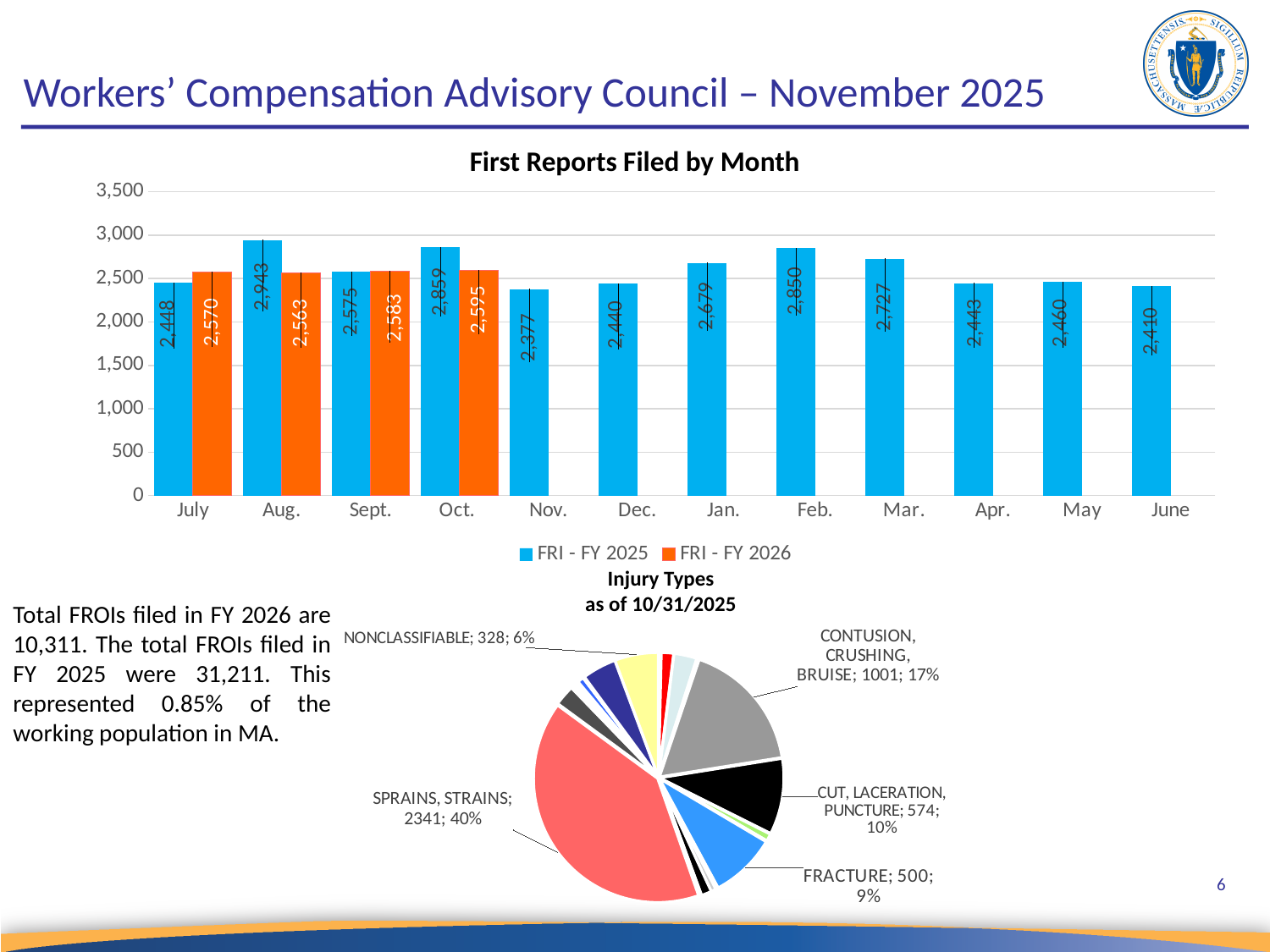
In the 'First Reports Filed by Month' chart, is the FRI - FY 2025 value for Feb. greater or less than 2,500? greater In the 'First Reports Filed by Month' chart, what is the FRI - FY 2026 value for Oct.? 2,595 How many months are shown on the x axis of the 'First Reports Filed by Month' chart? 12 In the 'First Reports Filed by Month' chart, what is the difference between the FRI - FY 2025 and FRI - FY 2026 values for Aug.? 380 In the 'Injury Types as of 10/31/2025' pie chart, what share does SPRAINS, STRAINS represent? 40% What kind of chart is 'First Reports Filed by Month'? bar chart In the 'Injury Types as of 10/31/2025' pie chart, what is the count for FRACTURE? 500 In the 'First Reports Filed by Month' chart, which month has the highest FRI - FY 2025 value? Aug. How many series does the legend of the 'First Reports Filed by Month' chart list? 2 In the 'First Reports Filed by Month' chart, which series has the larger value for July, FRI - FY 2025 or FRI - FY 2026? FRI - FY 2026 In the 'First Reports Filed by Month' chart, which month has the lowest FRI - FY 2025 value? Nov. In the 'First Reports Filed by Month' chart, what is the FRI - FY 2025 value for July? 2,448